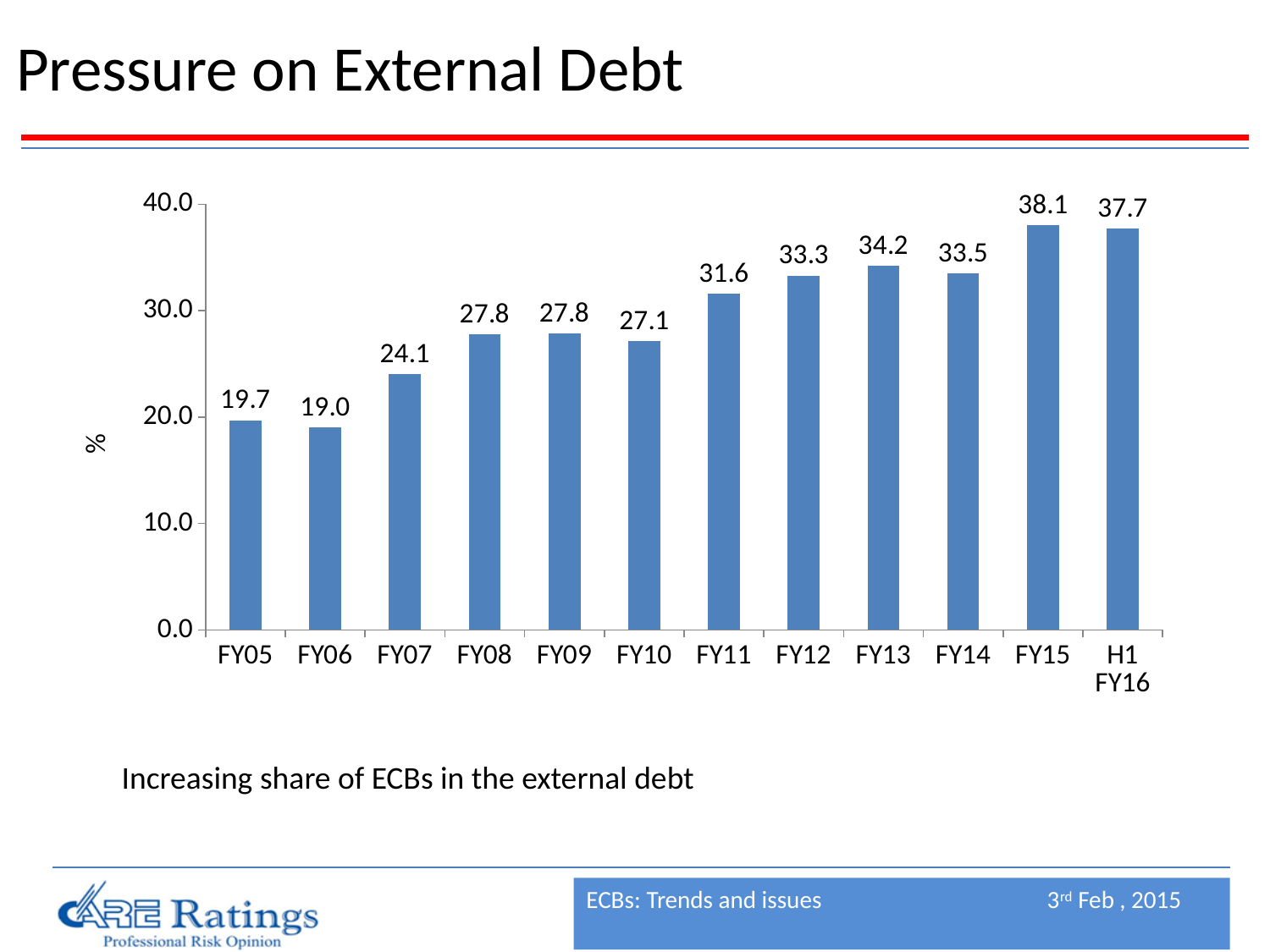
Is the value for FY10 greater or less than 30.0? less What is the value for FY11? 31.6 What is the value for H1 FY16? 37.7 What is the difference between the values for FY15 and FY05? 18.4 What is the label on the y axis? % Do the values generally rise or fall from FY05 to FY15? rise What is the value for FY05? 19.7 Which category has the highest value? FY15 Which is larger, the value for FY13 or the value for FY14? FY13 What kind of chart is shown on the slide? bar chart Which category has the lowest value? FY06 How many categories are shown on the x axis? 12